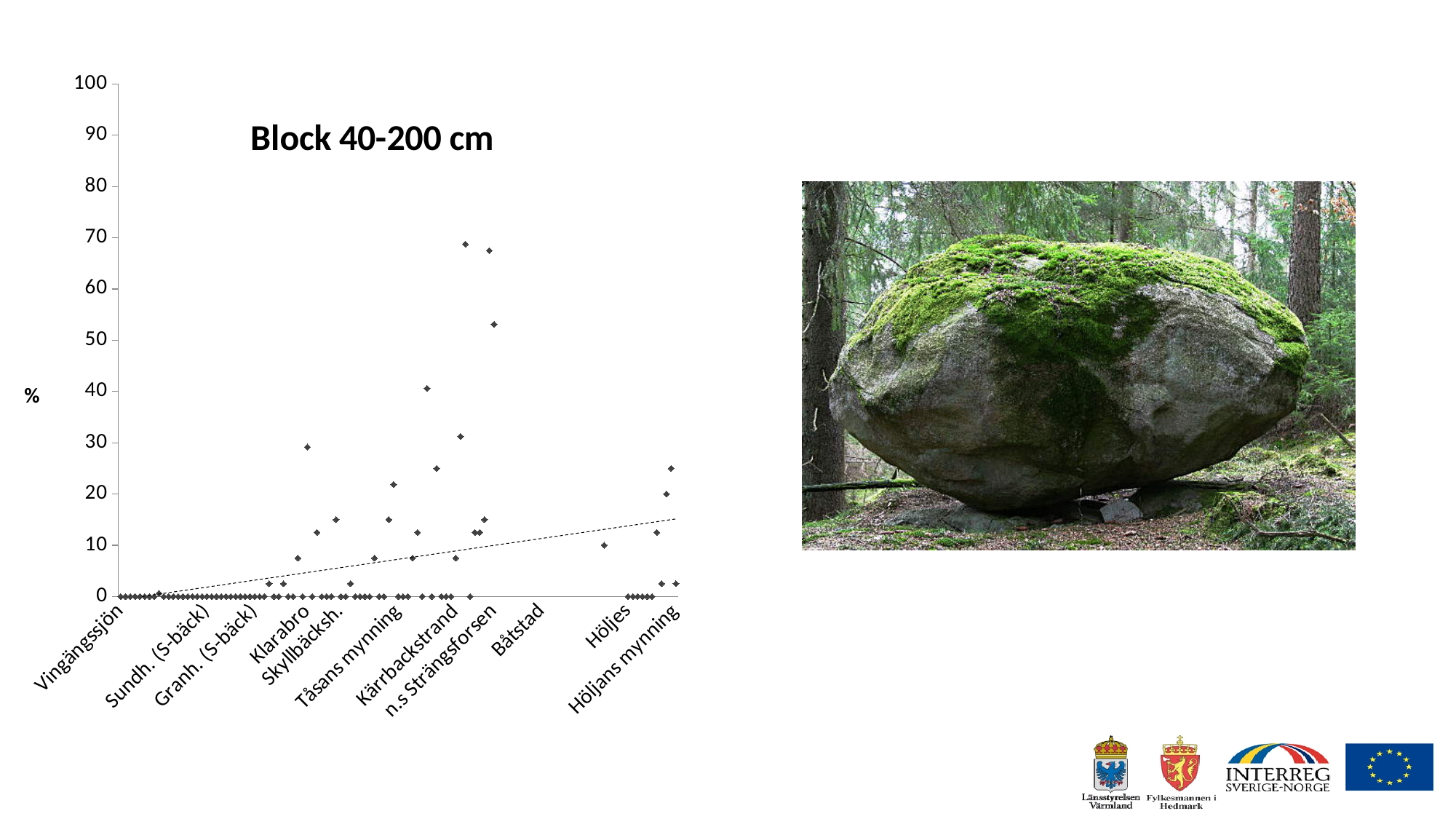
Is the highest plotted point in the chart greater or less than 80? less What is the title of the chart? Block 40-200 cm Which site label is last (rightmost) on the x axis of the chart? Höljans mynning How many site labels are shown along the x axis of the chart? 11 Is the dashed trend line at its right end greater or less than 20? less What is the label on the y axis of the chart? % What is the maximum value shown on the y axis of the chart? 100 Which site label is first (leftmost) on the x axis of the chart? Vingängssjön What kind of chart is shown on the slide? Scatter chart Does the dashed trend line in the chart rise or fall from left to right? Rise